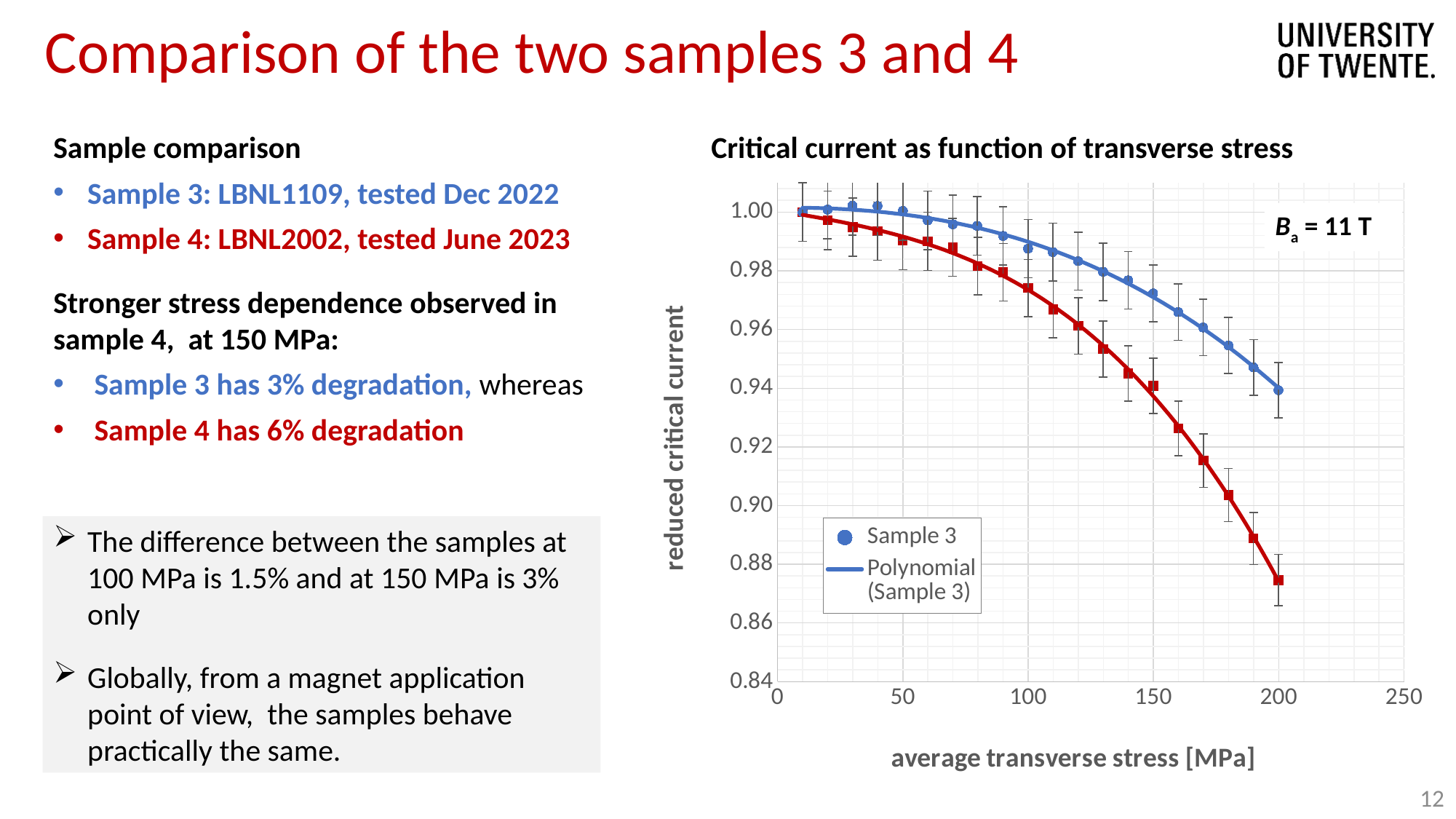
What kind of chart is shown on the slide? Scatter chart with polynomial trend lines At 200 MPa, which series has the higher reduced critical current, the blue Sample 3 series or the red Sample 4 series? Sample 3 (blue) How many series does the chart legend list? 2 Is the reduced critical current of the red Sample 4 series at 200 MPa greater or less than 0.90? less Do the reduced critical current values rise or fall as the average transverse stress increases? Fall Which series shows the steeper decline in reduced critical current with increasing stress, the blue Sample 3 series or the red Sample 4 series? Sample 4 (red) Is the reduced critical current of the blue Sample 3 series at 200 MPa greater or less than 0.92? greater What is the label of the x axis of the chart? average transverse stress [MPa] Is the reduced critical current of the blue Sample 3 series at 100 MPa greater or less than 0.98? greater What is the title of the chart? Critical current as function of transverse stress